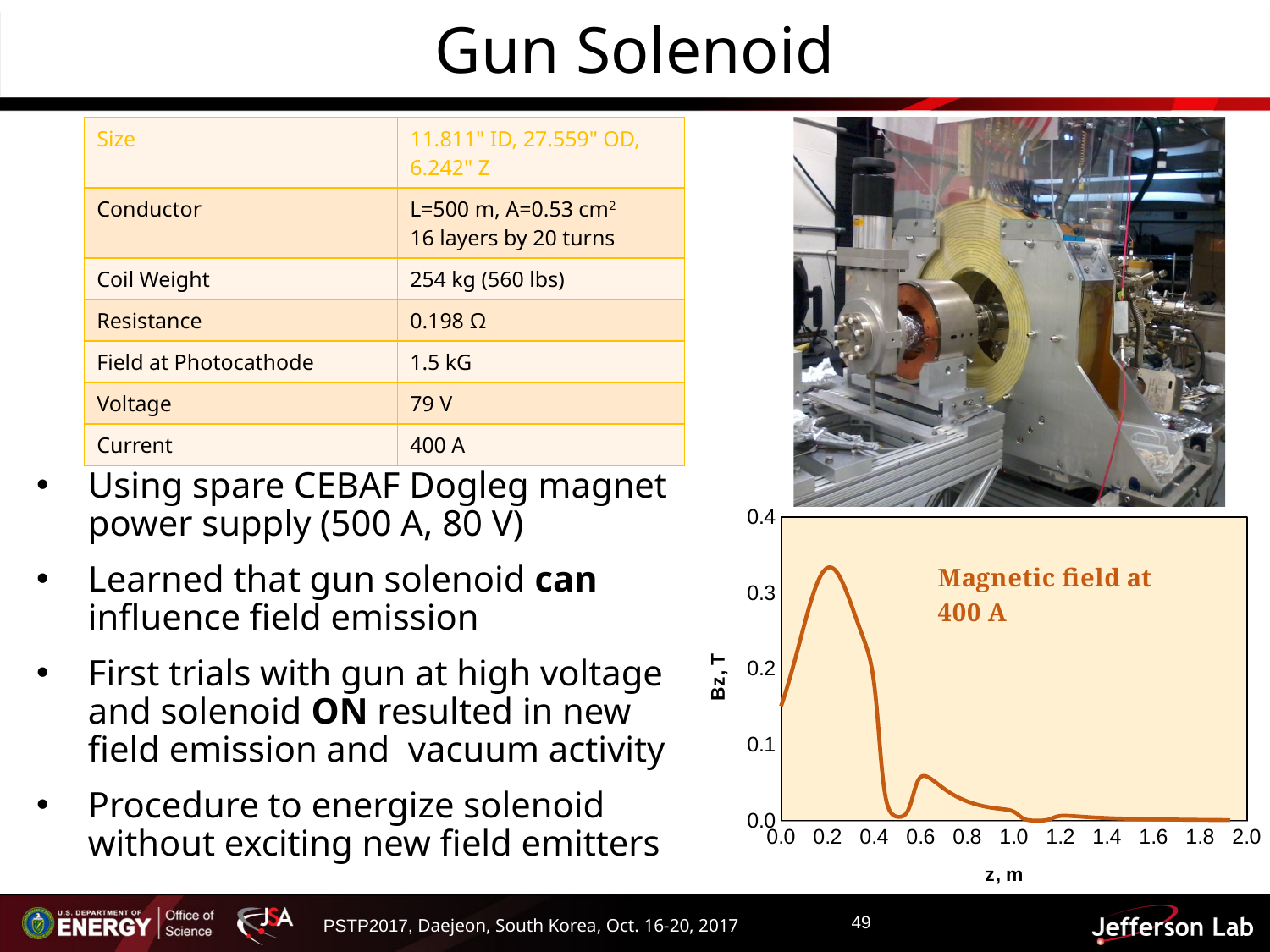
Which is larger, the value of Bz at z = 0.2 or at z = 0.6? z = 0.2 What is the label of the vertical axis of the chart? Bz, T Is the peak value of Bz on the chart greater or less than 0.3? greater What is the title printed inside the chart? Magnetic field at 400 A How many lines are plotted on the chart? 1 What is the highest tick value shown on the x axis of the chart? 2.0 Does the curve reach its maximum before or after z = 0.4? before Is the value of Bz at z = 1.0 greater or less than 0.1? less What kind of chart is shown on the slide? line chart Does Bz rise or fall along the x axis between z = 0.4 and z = 1.0? fall Is the value of Bz at z = 0.6 greater or less than 0.1? less